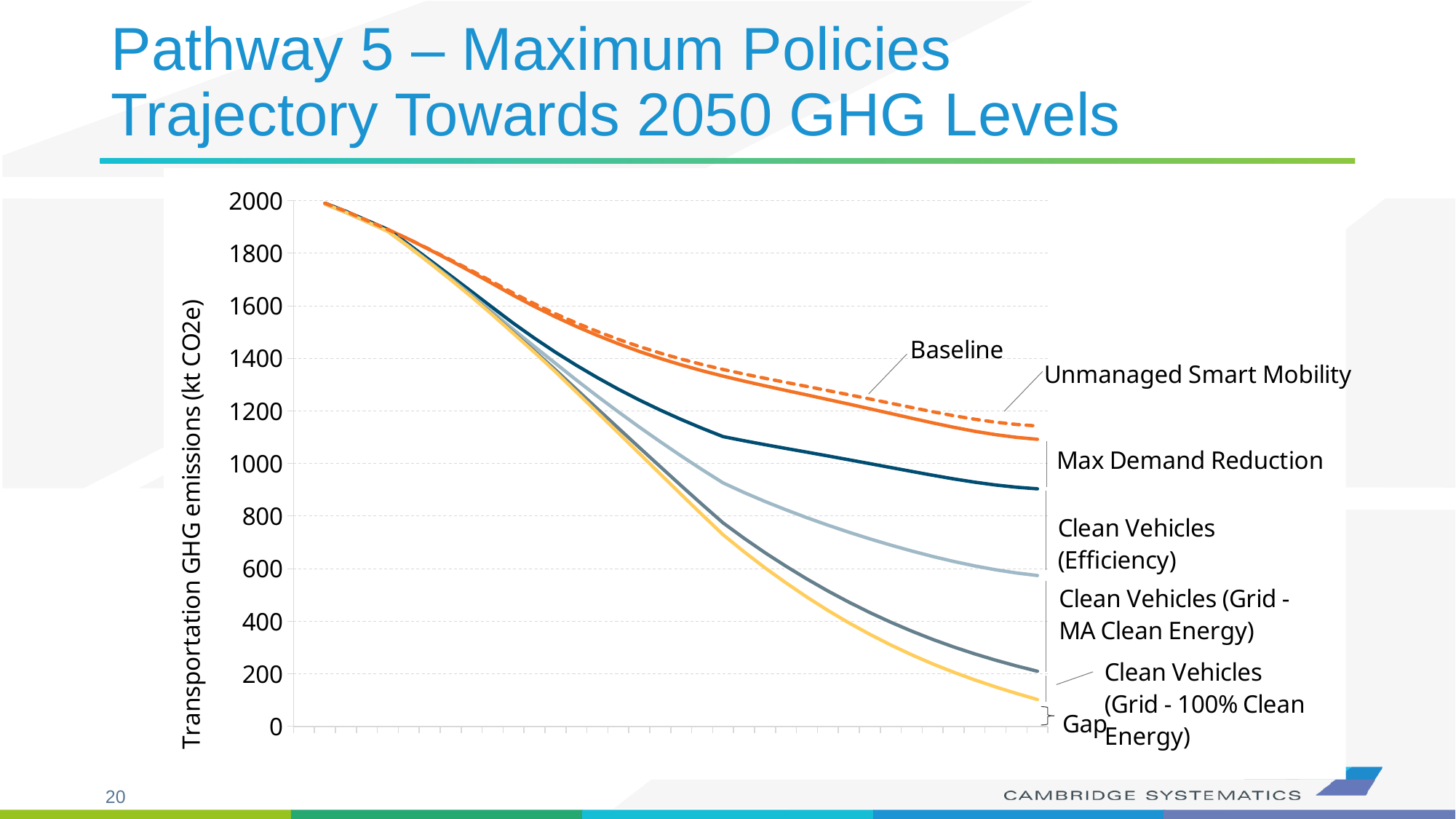
What is the label of the y axis? Transportation GHG emissions (kt CO2e) What kind of chart is shown on the slide? line chart Which series ends at the lowest value at the right end of the chart? Clean Vehicles (Grid - 100% Clean Energy) At the right end of the chart, is the value for Clean Vehicles (Efficiency) greater or less than 400? greater Do the values of the lines rise or fall from left to right along the x axis? fall How many series (lines) are labelled on the chart? 6 Which series ends at the highest value at the right end of the chart? Unmanaged Smart Mobility At the right end of the chart, which is larger: Max Demand Reduction or Clean Vehicles (Efficiency)? Max Demand Reduction At the right end of the chart, is the value for Clean Vehicles (Grid - MA Clean Energy) greater or less than 400? less At the right end of the chart, is the value for Clean Vehicles (Grid - 100% Clean Energy) greater or less than 200? less